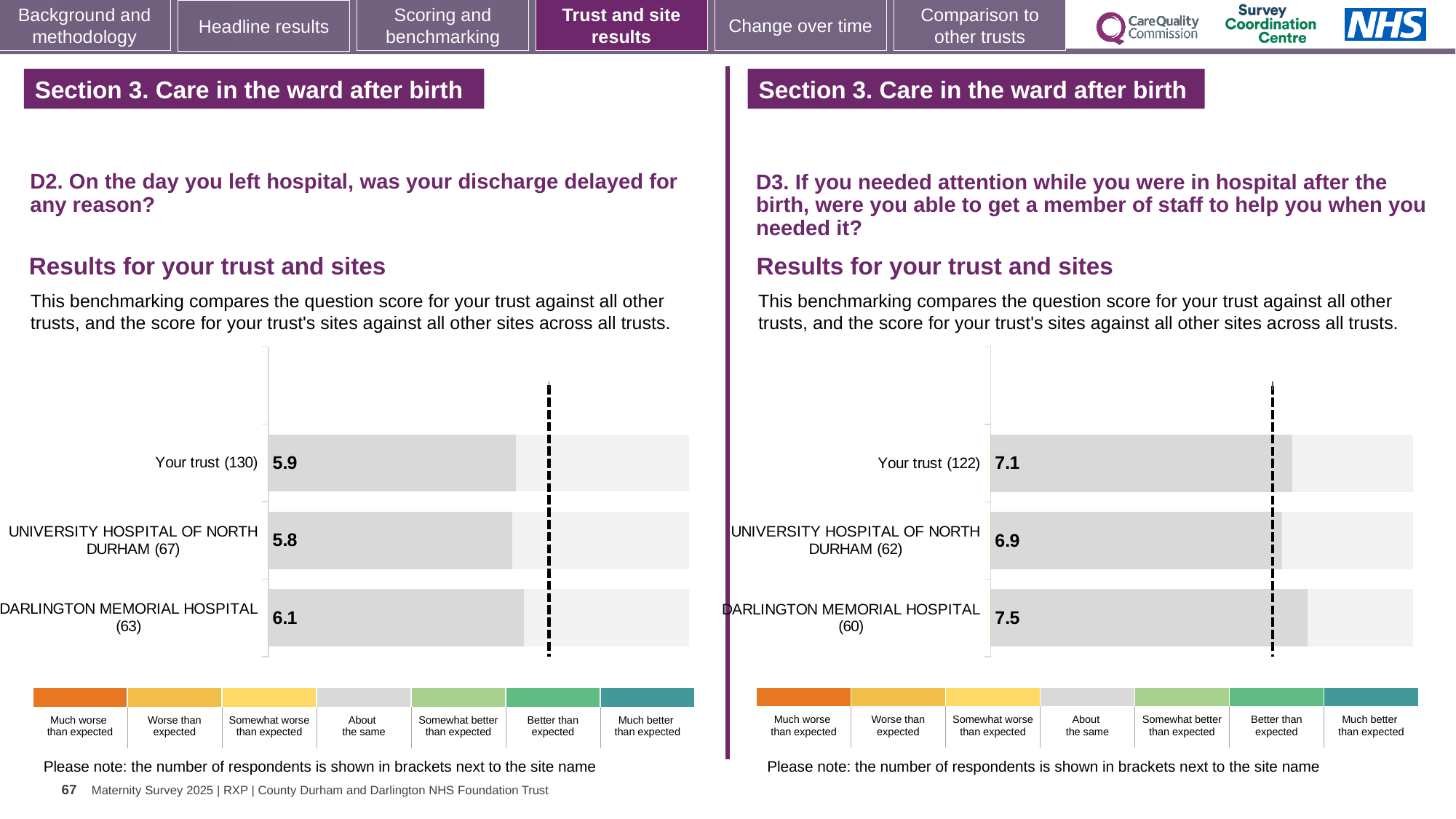
In the D2 chart (left), what is the difference between the scores for DARLINGTON MEMORIAL HOSPITAL and UNIVERSITY HOSPITAL OF NORTH DURHAM? 0.3 In the D3 chart (right), which site or trust has the highest score? DARLINGTON MEMORIAL HOSPITAL In the D2 chart (left), what is the score for Your trust? 5.9 In the D3 chart (right), what is the score for UNIVERSITY HOSPITAL OF NORTH DURHAM? 6.9 In the D3 chart (right), what is the difference between the scores for DARLINGTON MEMORIAL HOSPITAL and Your trust? 0.4 In the D2 chart (left), what is the score for DARLINGTON MEMORIAL HOSPITAL? 6.1 In the D2 chart (left), how many respondents are shown in brackets for Your trust? 130 In the D2 chart (left), which site or trust has the lowest score? UNIVERSITY HOSPITAL OF NORTH DURHAM In the D3 chart (right), how many respondents are shown in brackets for DARLINGTON MEMORIAL HOSPITAL? 60 What type of chart is used in the D2 chart (left)? Bar chart In the D3 chart (right), which has the larger score, Your trust or UNIVERSITY HOSPITAL OF NORTH DURHAM? Your trust How many bars are plotted in the D3 chart (right)? 3